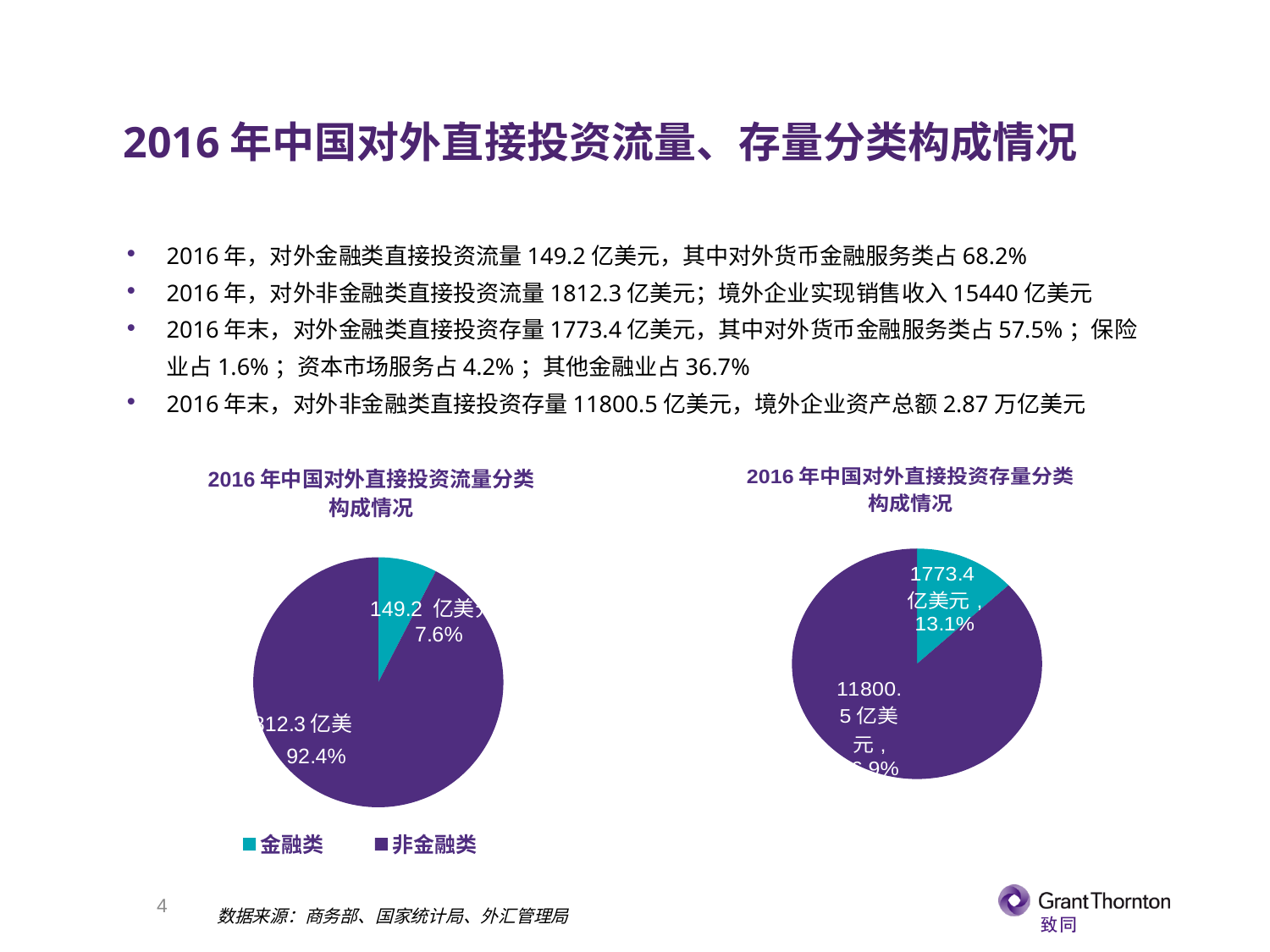
What kind of chart is the left chart titled 2016 年中国对外直接投资流量分类构成情况? Pie chart In the right chart (2016 年中国对外直接投资存量分类构成情况), what share of the pie does 金融类 represent? 13.1% In the right chart (2016 年中国对外直接投资存量分类构成情况), what is the value shown for 非金融类? 11800.5 亿美元 In the right chart (2016 年中国对外直接投资存量分类构成情况), what is the value shown for 金融类? 1773.4 亿美元 In the left chart (2016 年中国对外直接投资流量分类构成情况), what share of the pie does 金融类 represent? 7.6% How many slices does the left chart (2016 年中国对外直接投资流量分类构成情况) have? 2 In the right chart (2016 年中国对外直接投资存量分类构成情况), which category has the largest slice? 非金融类 Which two categories are listed in the legend below the pie charts? 金融类 and 非金融类 In the left chart (2016 年中国对外直接投资流量分类构成情况), what is the value shown for 金融类? 149.2 亿美元 In the left chart (2016 年中国对外直接投资流量分类构成情况), what share of the pie does 非金融类 represent? 92.4% In the left chart (2016 年中国对外直接投资流量分类构成情况), which category has the larger slice, 金融类 or 非金融类? 非金融类 What is the difference between the 金融类 share in the right chart (13.1%) and the 金融类 share in the left chart (7.6%)? 5.5 percentage points